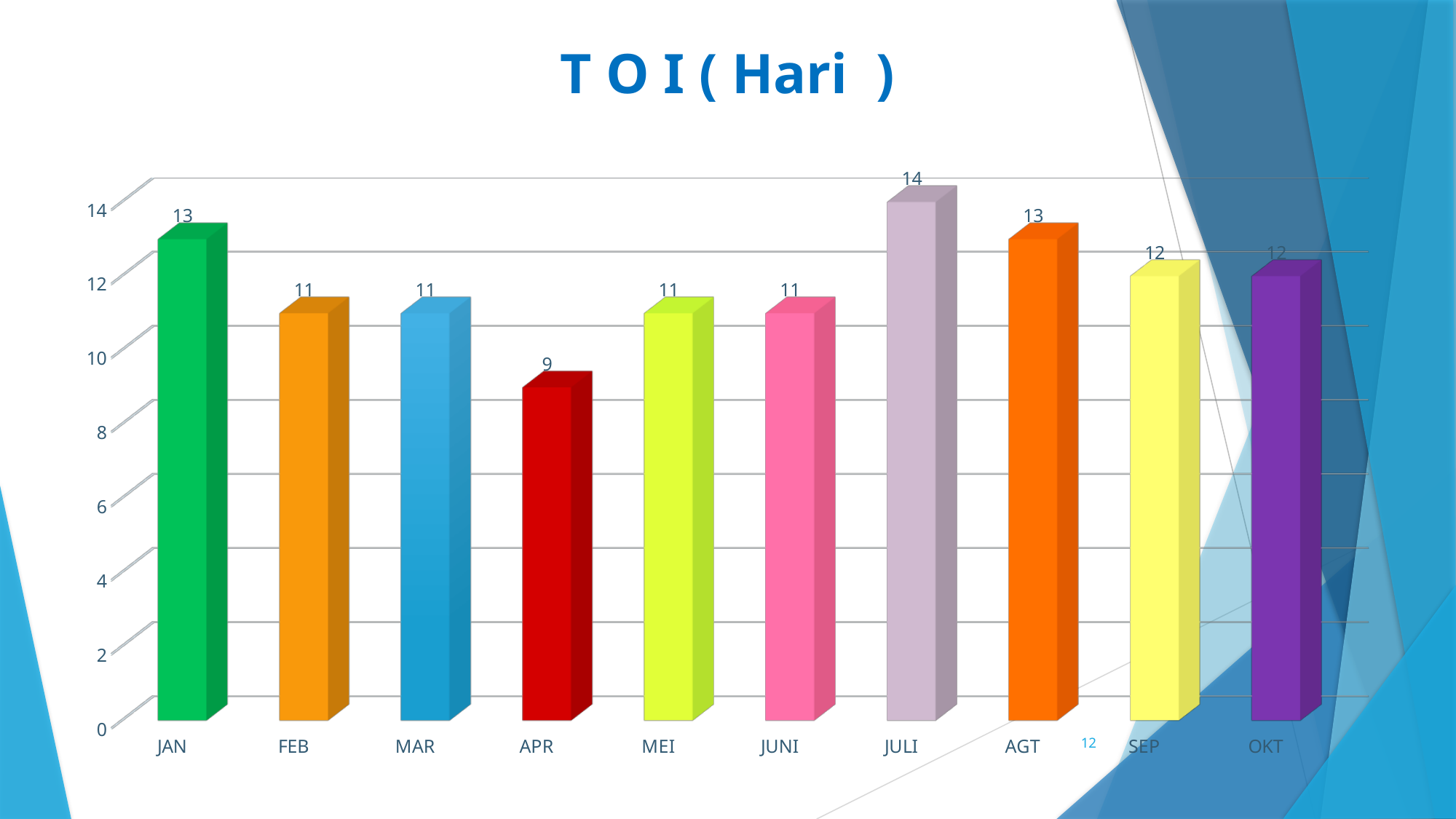
What kind of chart is shown on the slide? bar chart How many months are shown on the x axis? 10 Which is larger, the value for AGT or the value for OKT? AGT What is the value for APR? 9 Which month has the lowest value? APR What is the value for JULI? 14 Is the value for FEB greater or less than 12? less Which month has the highest value? JULI What is the difference between the values for JULI and APR? 5 What is the value for JAN? 13 What is the title of the chart? T O I ( Hari ) What is the value for SEP? 12